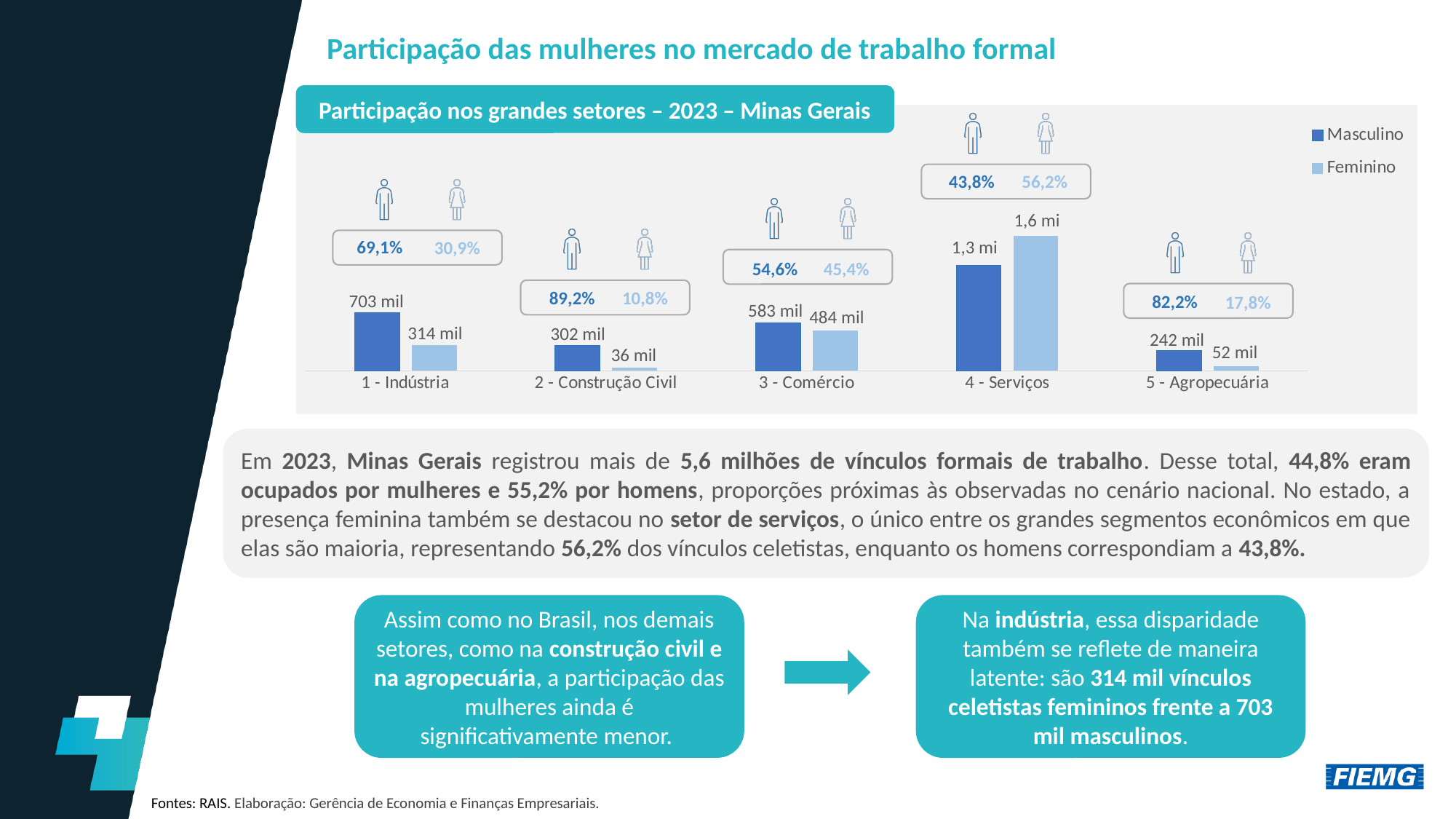
Which sector has the lowest Feminino value? 2 - Construção Civil What is the Feminino value for 4 - Serviços? 1,6 mi What is the difference between the Masculino and Feminino values for 3 - Comércio? 99 mil What is the Feminino value for 2 - Construção Civil? 36 mil Which sector has the highest Feminino value? 4 - Serviços How many series does the legend list? 2 How many sectors are shown on the x axis of the chart? 5 What is the difference between the Masculino and Feminino values for 1 - Indústria? 389 mil What is the Masculino value for 5 - Agropecuária? 242 mil What percentage share is shown for Feminino in 3 - Comércio? 45,4% What is the Masculino value for 1 - Indústria? 703 mil Which is larger in 4 - Serviços, the Masculino value or the Feminino value? Feminino